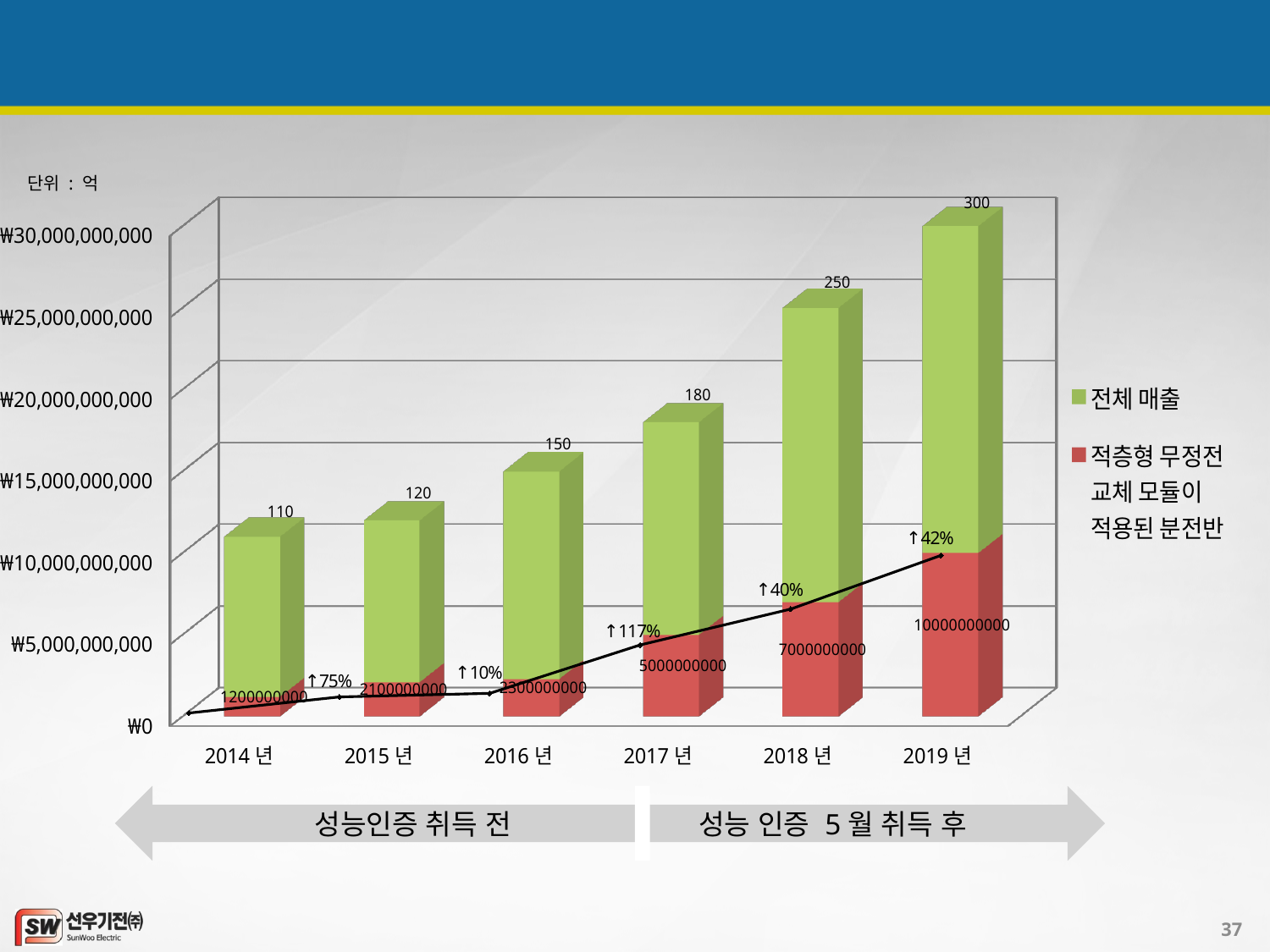
What is the value of 전체 매출 for 2014 년? 110 Which is larger, the 전체 매출 value for 2016 년 or for 2015 년? 2016 년 What is the value of 적층형 무정전 교체 모듈이 적용된 분전반 for 2019 년? 10000000000 What is the value of 적층형 무정전 교체 모듈이 적용된 분전반 for 2017 년? 5000000000 Do the 전체 매출 values rise or fall from 2014 년 to 2019 년? rise Which year has the lowest 적층형 무정전 교체 모듈이 적용된 분전반 value? 2014 년 What is the difference between the 전체 매출 values for 2018 년 and 2017 년? 70 What is the value of 전체 매출 for 2019 년? 300 How many years are shown on the x axis? 6 How many series does the legend list? 2 What percentage increase is labelled on the line between 2016 년 and 2017 년? ↑117% Which year has the highest 전체 매출 value? 2019 년